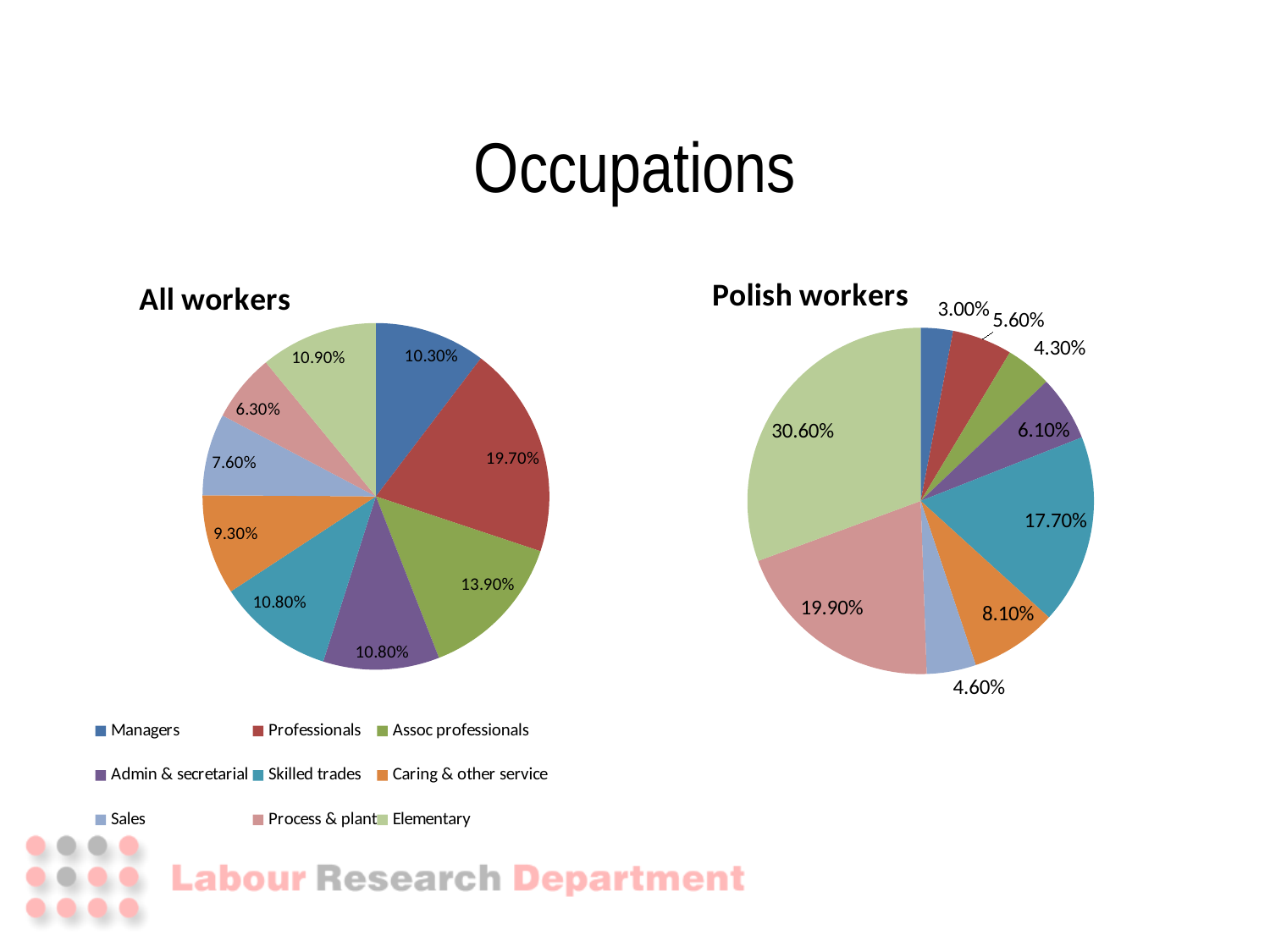
In the 'Polish workers' chart, what share does the Elementary category have? 30.60% What type of chart is used for the 'All workers' data? pie chart In the 'Polish workers' chart, what share do Skilled trades have? 17.70% In the 'All workers' chart, what share do Professionals have? 19.70% In the 'All workers' chart, what share do Sales workers have? 7.60% In the 'All workers' chart, which occupation has the smallest share? Process & plant In the 'All workers' chart, which occupation has the largest share? Professionals In the 'Polish workers' chart, which occupation has the largest share? Elementary In the 'Polish workers' chart, which occupation has the smallest share? Managers How many occupation categories does the legend list? 9 What is the difference between the Elementary share in the 'Polish workers' chart and the Elementary share in the 'All workers' chart? 19.70% Which is larger: the Managers share in the 'All workers' chart or the Managers share in the 'Polish workers' chart? All workers